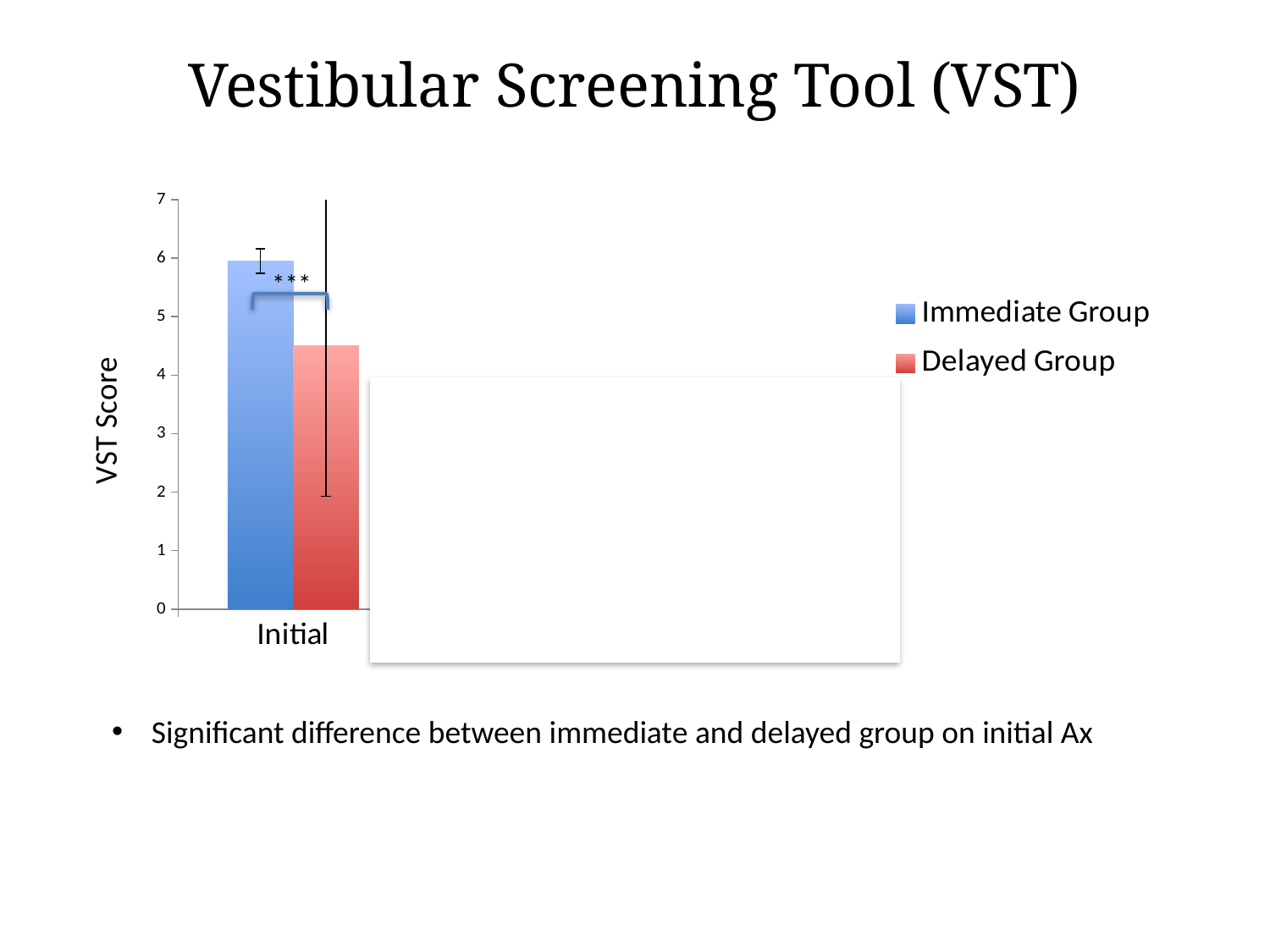
What is the highest value shown on the vertical axis of the chart? 7 Which two groups are listed in the chart legend? Immediate Group and Delayed Group What kind of chart is shown on the slide? bar chart For the Initial assessment, which group has the higher VST Score, the Immediate Group or the Delayed Group? Immediate Group Is the Initial VST Score for the Immediate Group greater or less than 5? greater Is the Initial VST Score for the Delayed Group greater or less than 4? greater What is the label on the vertical axis of the chart? VST Score How many series does the chart legend list? 2 Is the Initial VST Score for the Delayed Group greater or less than 5? less